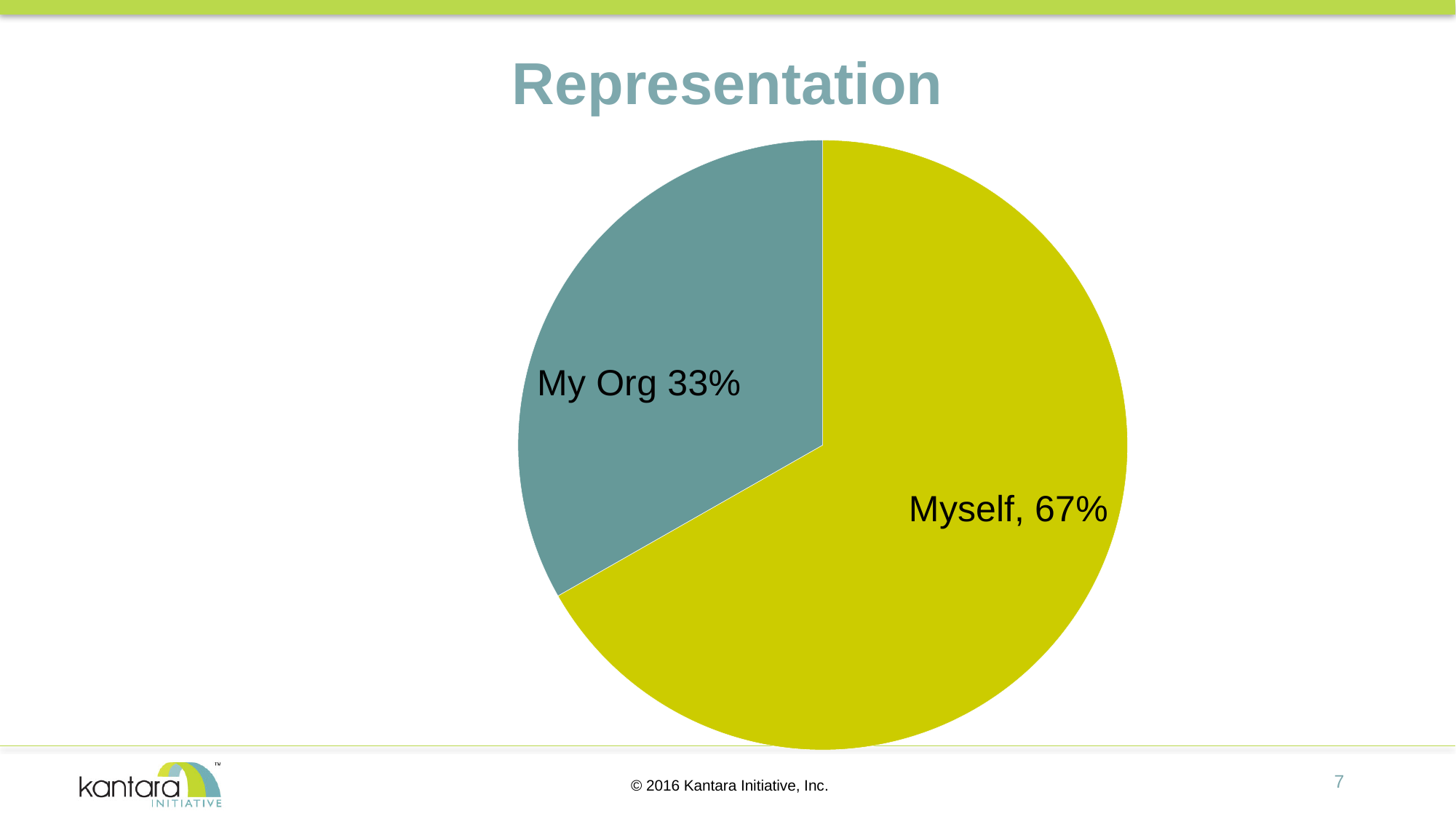
How many slices does the pie chart have? 2 What share of the pie does the Myself slice represent? 67% What share of the pie does the My Org slice represent? 33% What is the title of the chart? Representation Which slice is the smallest? My Org Which slice is the largest? Myself Which is larger, the Myself slice or the My Org slice? Myself What kind of chart is shown on the slide? pie chart What is the difference in percentage points between the Myself and My Org slices? 34 What colour is the Myself slice? yellow-green